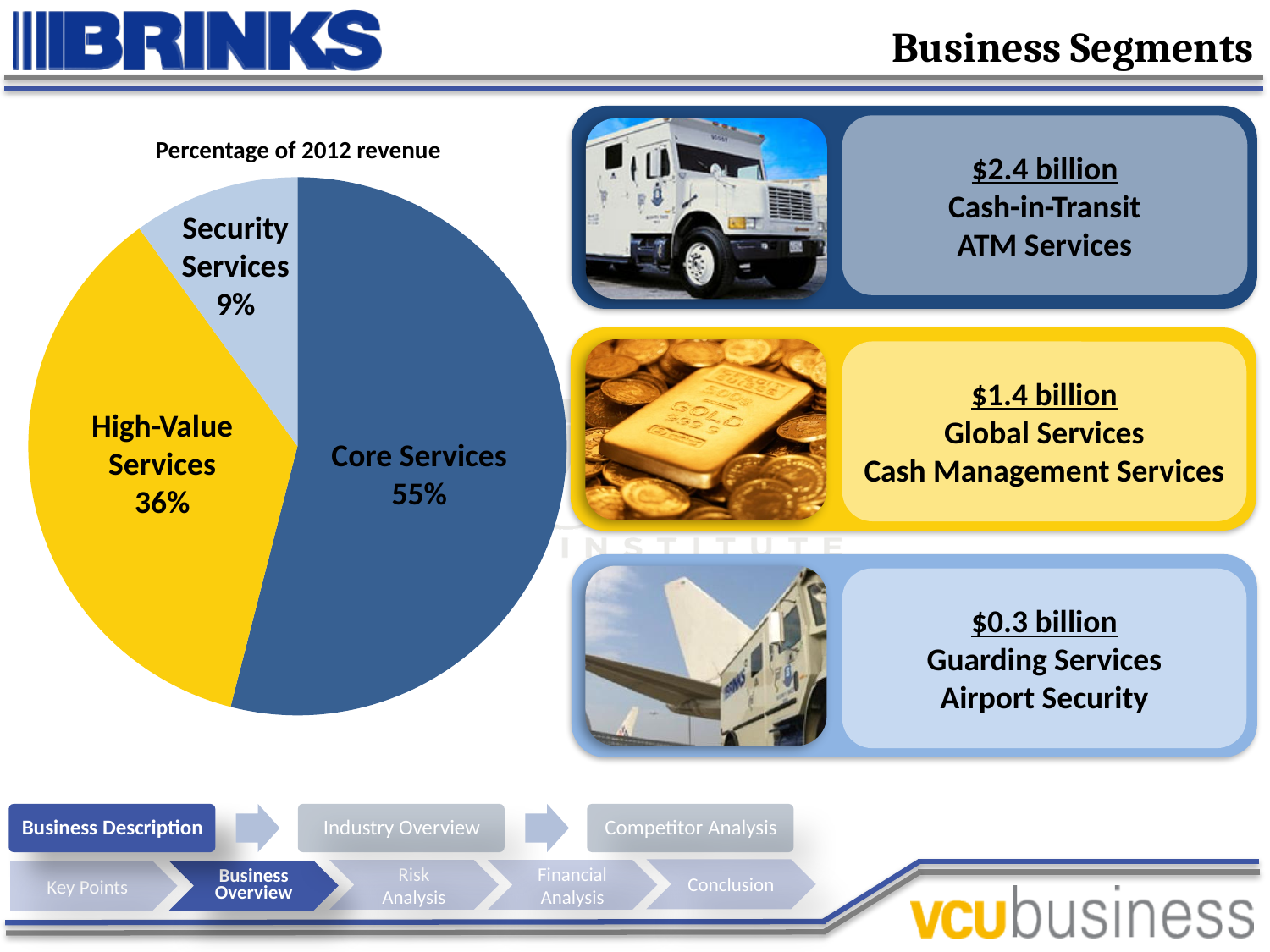
What is the difference in percentage points between High-Value Services and Security Services? 27 What percentage of 2012 revenue comes from Core Services? 55% What is the title of the pie chart? Percentage of 2012 revenue How many segments are shown in the pie chart? 3 What percentage of 2012 revenue comes from High-Value Services? 36% What kind of chart is shown on the slide? pie chart What colour is the High-Value Services slice of the pie chart? yellow What percentage of 2012 revenue comes from Security Services? 9% What is the difference in percentage points between Core Services and High-Value Services? 19 Which segment has the smallest share of 2012 revenue? Security Services Which has a larger share of 2012 revenue, High-Value Services or Security Services? High-Value Services Which segment has the largest share of 2012 revenue? Core Services